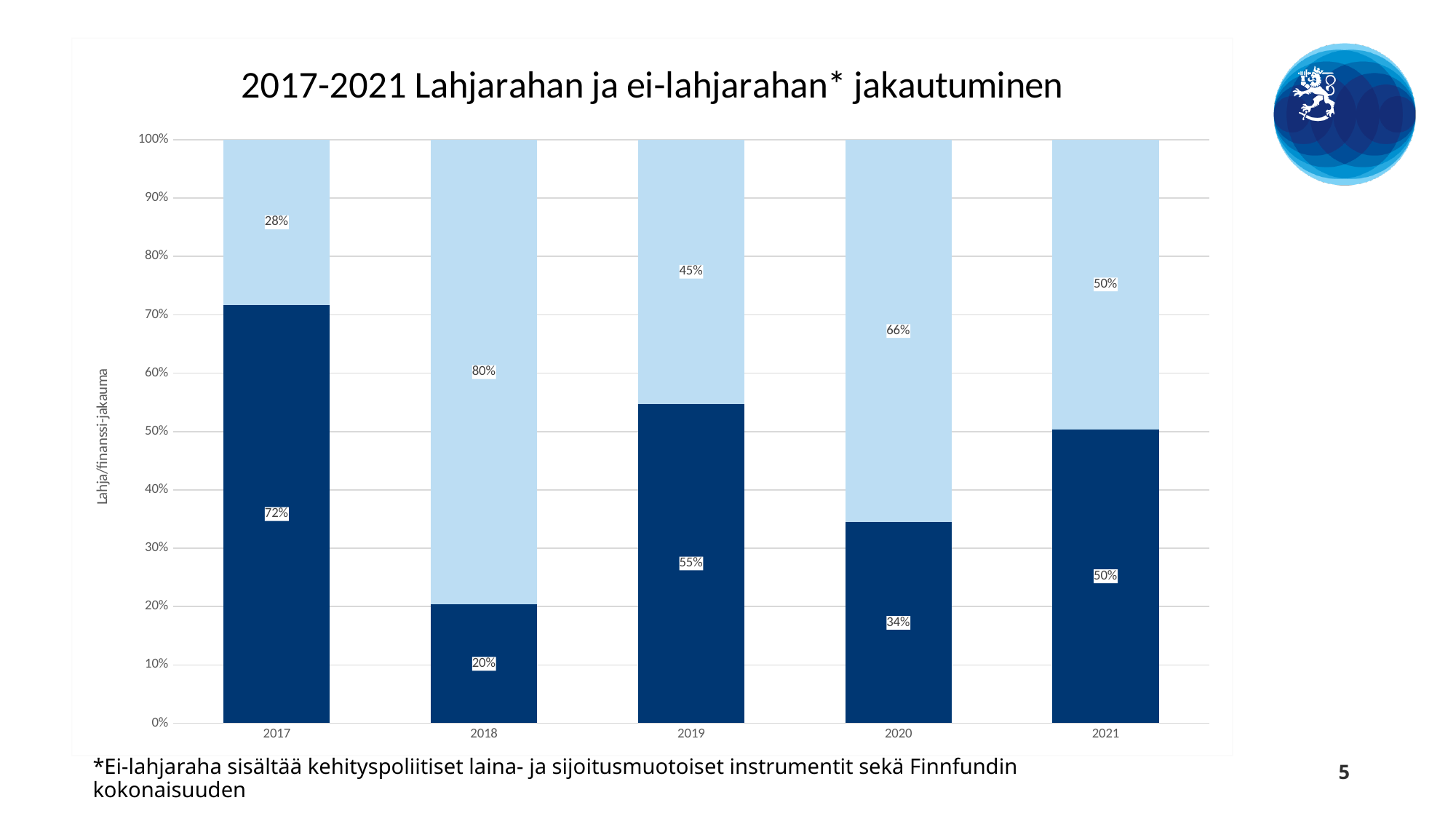
What is the value of the light blue segment for 2018? 80% In which year is the dark blue segment the largest? 2017 How many years are shown on the x axis of the chart? 5 What is the value of the dark blue segment for 2020? 34% What is the value of the dark blue segment for 2017? 72% What is the label on the vertical axis of the chart? Lahja/finanssi-jakauma In which year is the dark blue segment the smallest? 2018 What is the value of the light blue segment for 2019? 45% What is the title of the chart? 2017-2021 Lahjarahan ja ei-lahjarahan* jakautuminen Which is larger in 2020, the dark blue segment or the light blue segment? The light blue segment What type of chart is shown on the slide? Stacked bar chart What is the difference between the dark blue segment values for 2017 and 2018? 52%